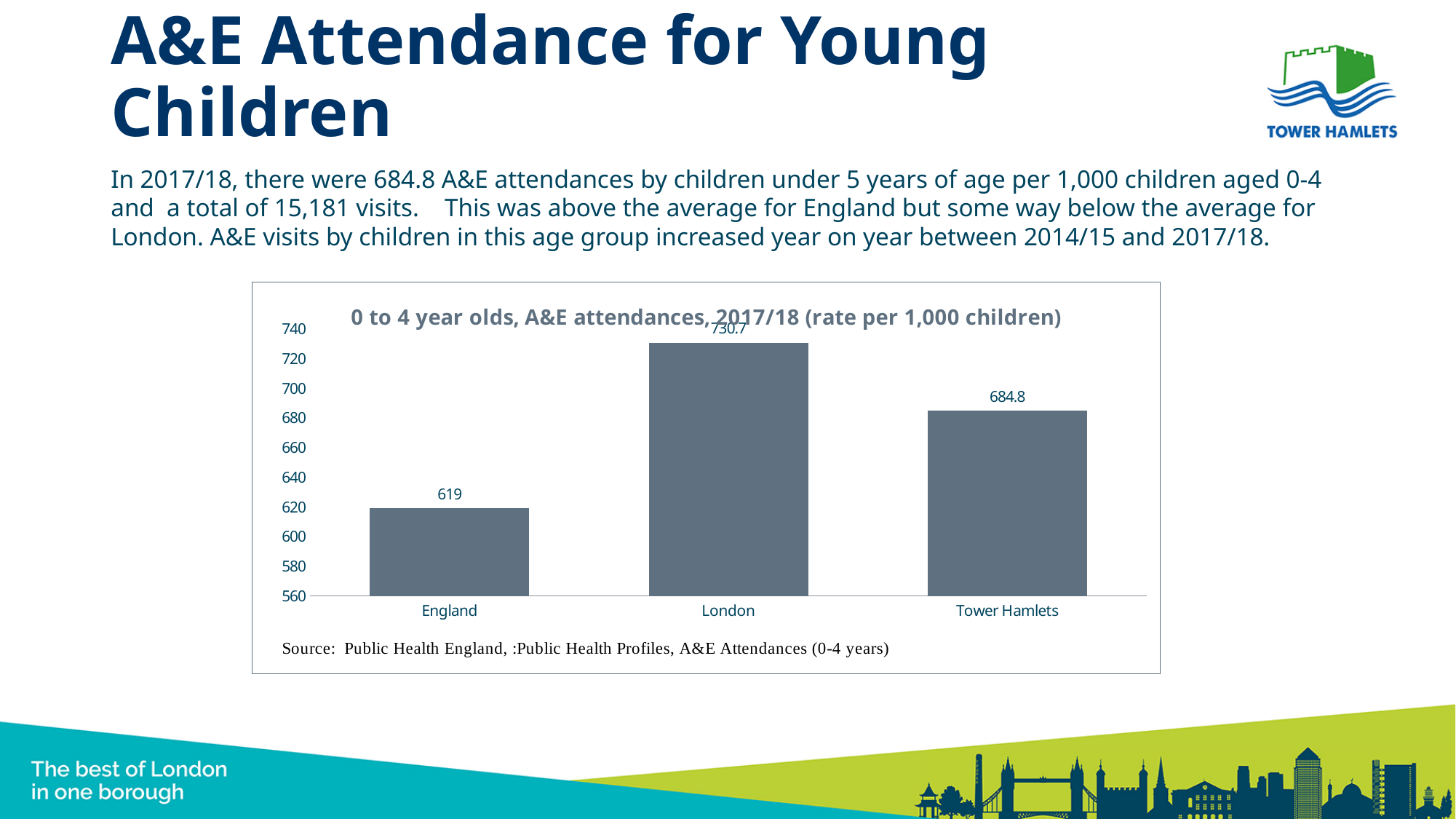
What is the difference between the London and Tower Hamlets A&E attendance rates? 45.9 Which area has the highest A&E attendance rate? London What is the title of the chart? 0 to 4 year olds, A&E attendances, 2017/18 (rate per 1,000 children) What type of chart is shown on the slide? Bar chart What is the A&E attendance rate per 1,000 children for London? 730.7 Which area has the lowest A&E attendance rate? England What is the A&E attendance rate per 1,000 children for Tower Hamlets? 684.8 What is the difference between the Tower Hamlets and England A&E attendance rates? 65.8 Is the value for Tower Hamlets greater or less than 700? less What is the A&E attendance rate per 1,000 children for England? 619 Which has a higher A&E attendance rate, Tower Hamlets or England? Tower Hamlets How many areas are shown in the chart? 3